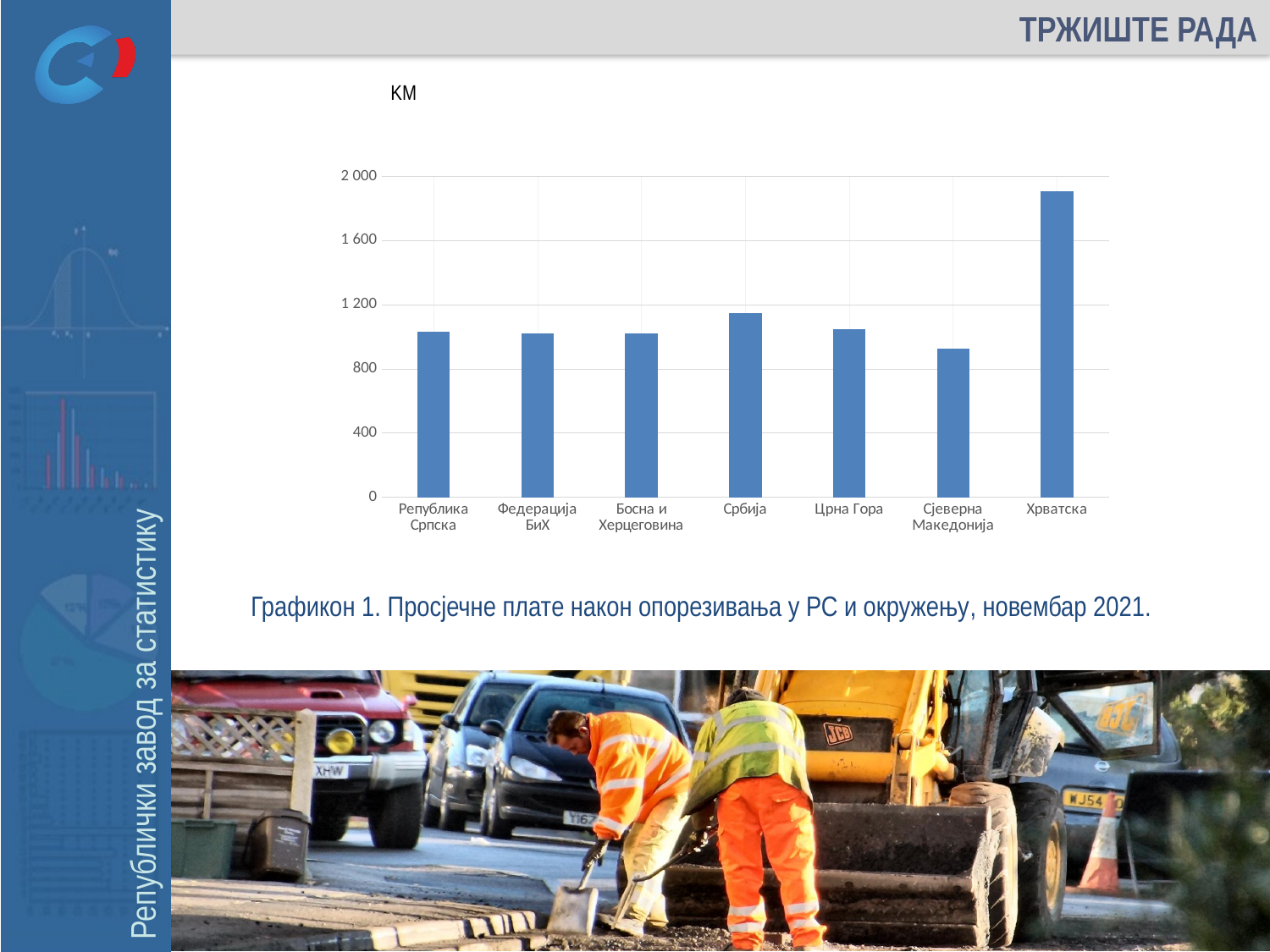
Is the value for Хрватска greater or less than 1 600? greater What is the caption of the chart on the slide? Графикон 1. Просјечне плате након опорезивања у РС и окружењу, новембар 2021. Is the value for Србија greater or less than 1 200? less Which is larger, the value for Хрватска or the value for Србија? Хрватска How many countries/entities are shown on the x axis of the chart? 7 Is the value for Црна Гора greater or less than 1 200? less Which category has the highest average net wage in the chart? Хрватска What unit is shown above the vertical axis of the chart? KM What kind of chart is shown on the slide? bar chart Which category has the lowest average net wage in the chart? Сјеверна Македонија Which is larger, the value for Србија or the value for Сјеверна Македонија? Србија